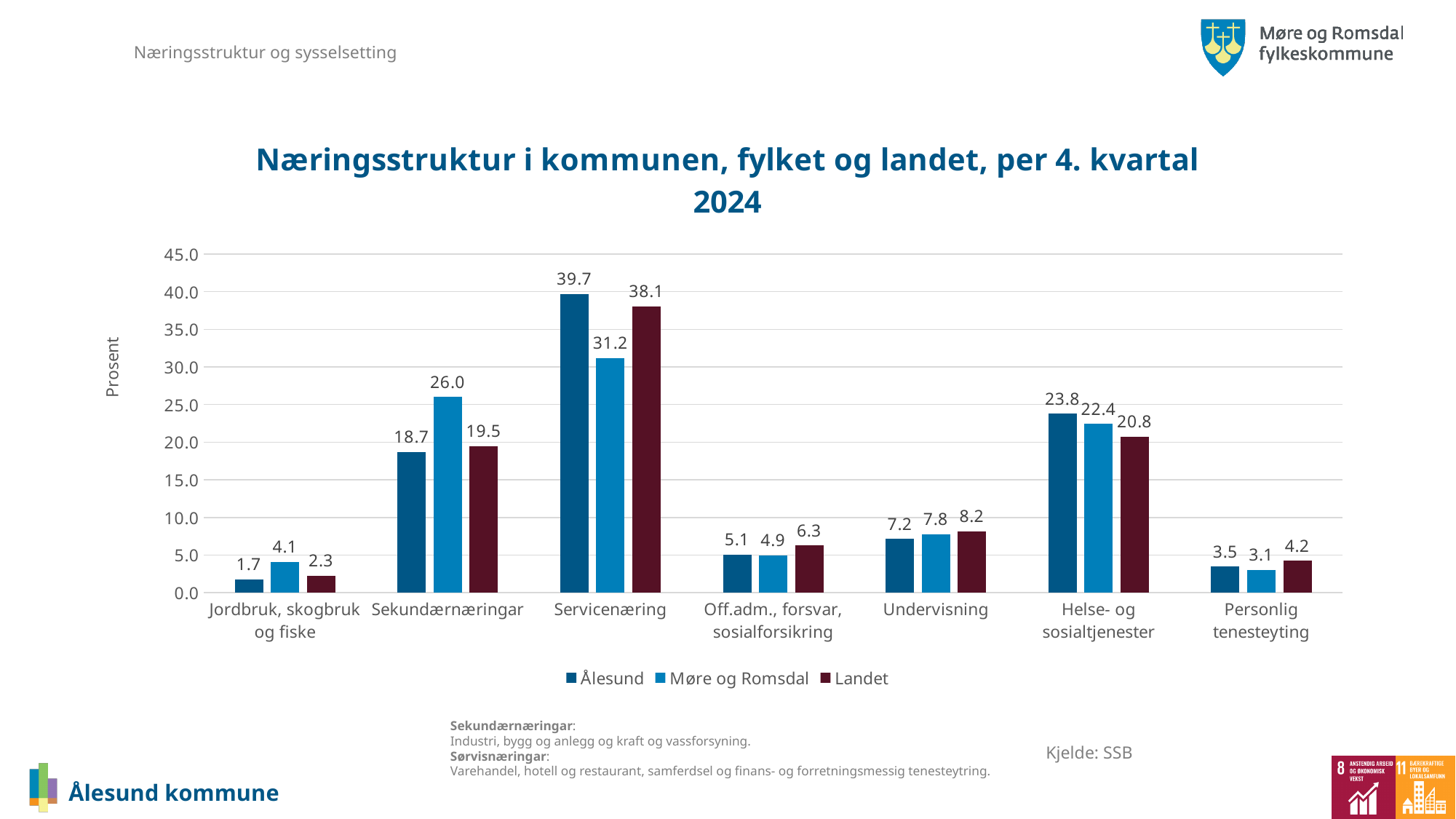
What is the value for Landet in the Helse- og sosialtjenester category? 20.8 Which category has the highest value for Ålesund? Servicenæring How many series does the legend list? 3 What is the difference between the Ålesund and Møre og Romsdal values for Servicenæring? 8.5 What is the value for Møre og Romsdal in the Sekundærnæringar category? 26.0 Which category has the lowest value for Landet? Jordbruk, skogbruk og fiske What is the value for Ålesund in the Servicenæring category? 39.7 What is the label of the y axis? Prosent Which is larger in the Undervisning category: the value for Ålesund or the value for Landet? Landet How many categories are shown on the x axis? 7 What kind of chart is shown on the slide? Bar chart Is the value for Møre og Romsdal in Helse- og sosialtjenester greater or less than 20.0? greater